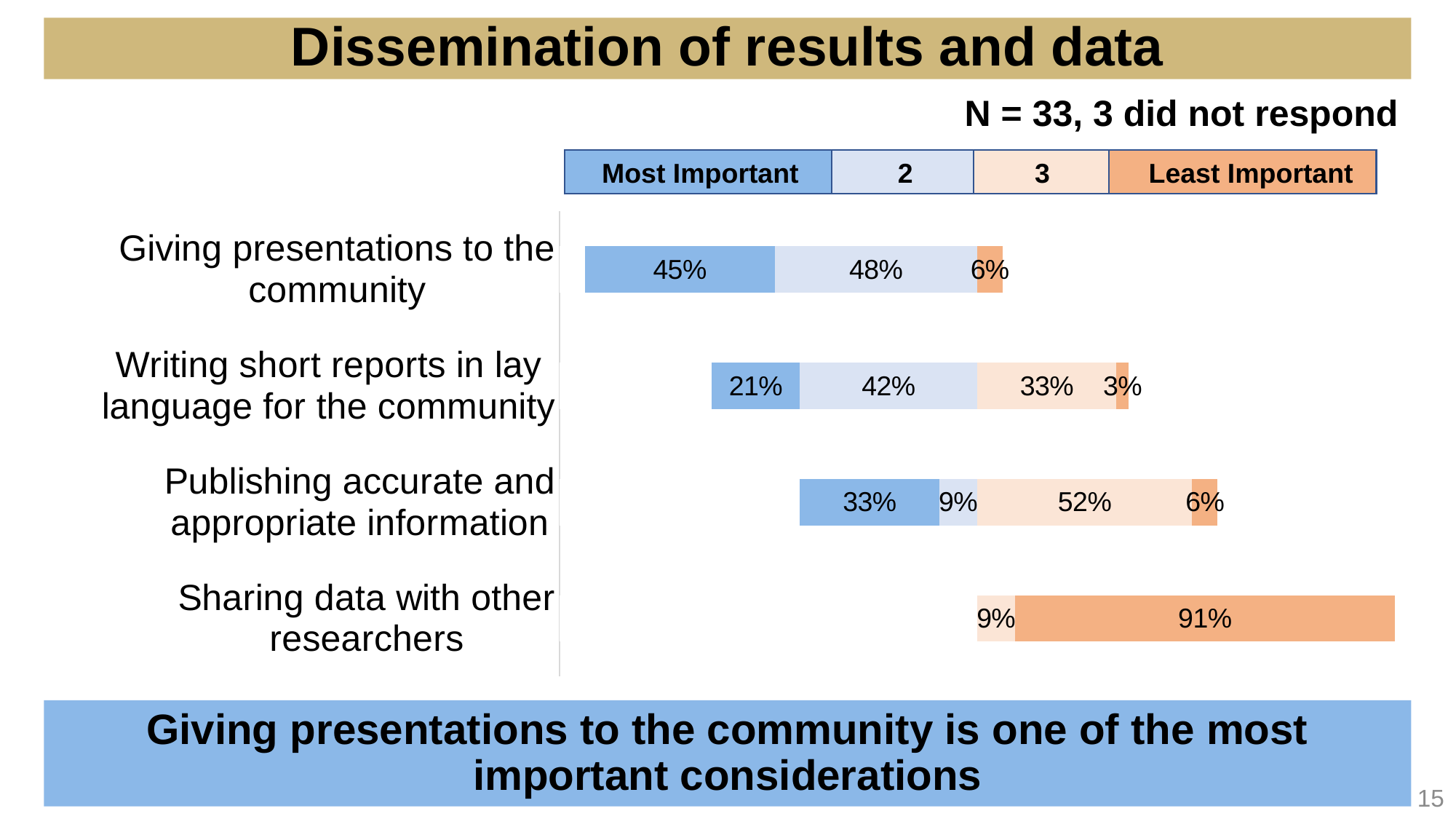
What is the value for rating '2' for 'Publishing accurate and appropriate information'? 9% How many categories (dissemination activities) are plotted in the chart? 4 What is the difference in the Most Important percentage between 'Giving presentations to the community' and 'Writing short reports in lay language for the community'? 24 percentage points What percentage rated 'Sharing data with other researchers' as Least Important? 91% What is the value for rating '3' for 'Publishing accurate and appropriate information'? 52% What percentage rated 'Writing short reports in lay language for the community' as Most Important? 21% According to the note on the slide, how many respondents did not respond? 3 Which category has the highest Least Important percentage? Sharing data with other researchers What percentage rated 'Giving presentations to the community' as Most Important? 45% What kind of chart is shown on the slide? Stacked bar chart How many series does the chart legend list? 4 Which category has the highest Most Important percentage? Giving presentations to the community